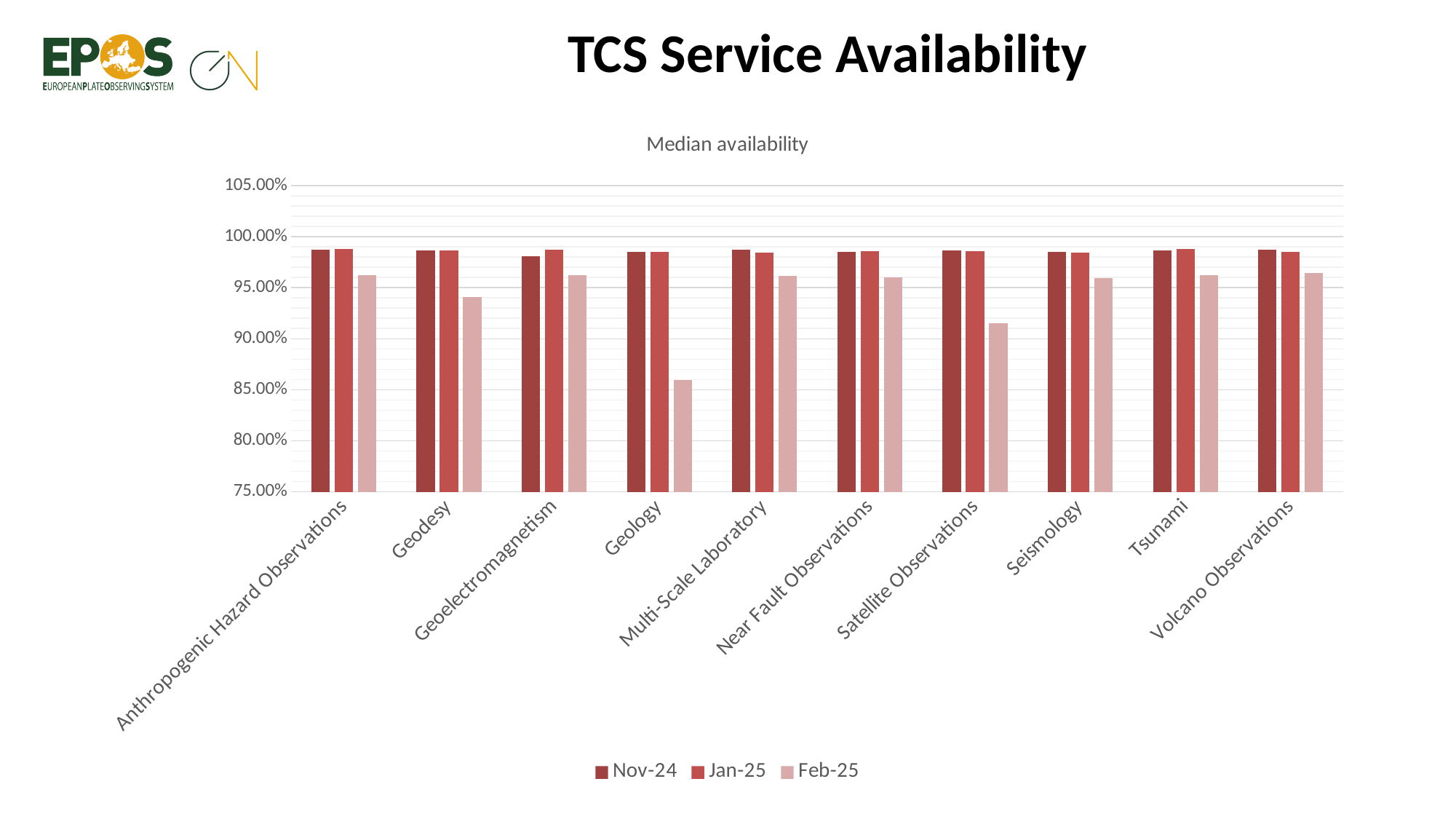
Is the Nov-24 value for Geology greater or less than 95.00%? greater Is the Feb-25 value for Geodesy greater or less than 95.00%? less Is the Feb-25 value for Satellite Observations greater or less than 95.00%? less What kind of chart is shown on the slide? bar chart How many categories are shown on the x axis? 10 How many series does the legend list? 3 What are the three legend entries of the chart? Nov-24, Jan-25, Feb-25 Which category has the lowest Feb-25 value? Geology Which is larger, the Feb-25 value for Satellite Observations or the Feb-25 value for Geology? Satellite Observations Which is larger, the Feb-25 value for Geodesy or the Feb-25 value for Geology? Geodesy